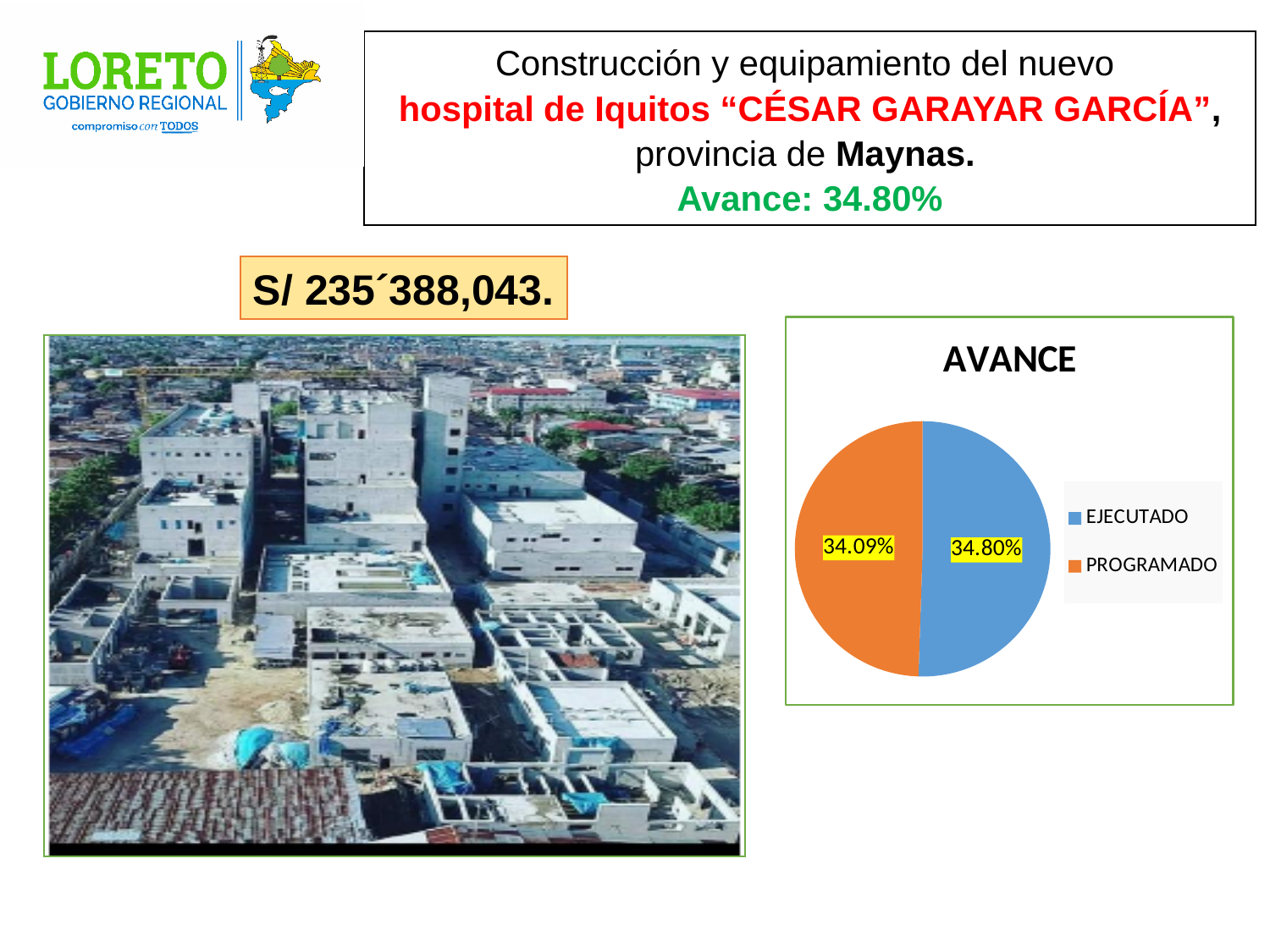
What is the title of the pie chart? AVANCE What value is shown for PROGRAMADO in the pie chart? 34.09% Is the value for EJECUTADO larger or smaller than the value for PROGRAMADO? larger Which slice of the pie chart has the lower value? PROGRAMADO How many entries does the legend of the pie chart list? 2 What colour is the EJECUTADO slice in the pie chart? blue What kind of chart is shown on the slide? pie chart Which slice of the pie chart has the higher value? EJECUTADO What value is shown for EJECUTADO in the pie chart? 34.80% What is the difference between the EJECUTADO and PROGRAMADO values in the pie chart? 0.71% How many slices does the pie chart have? 2